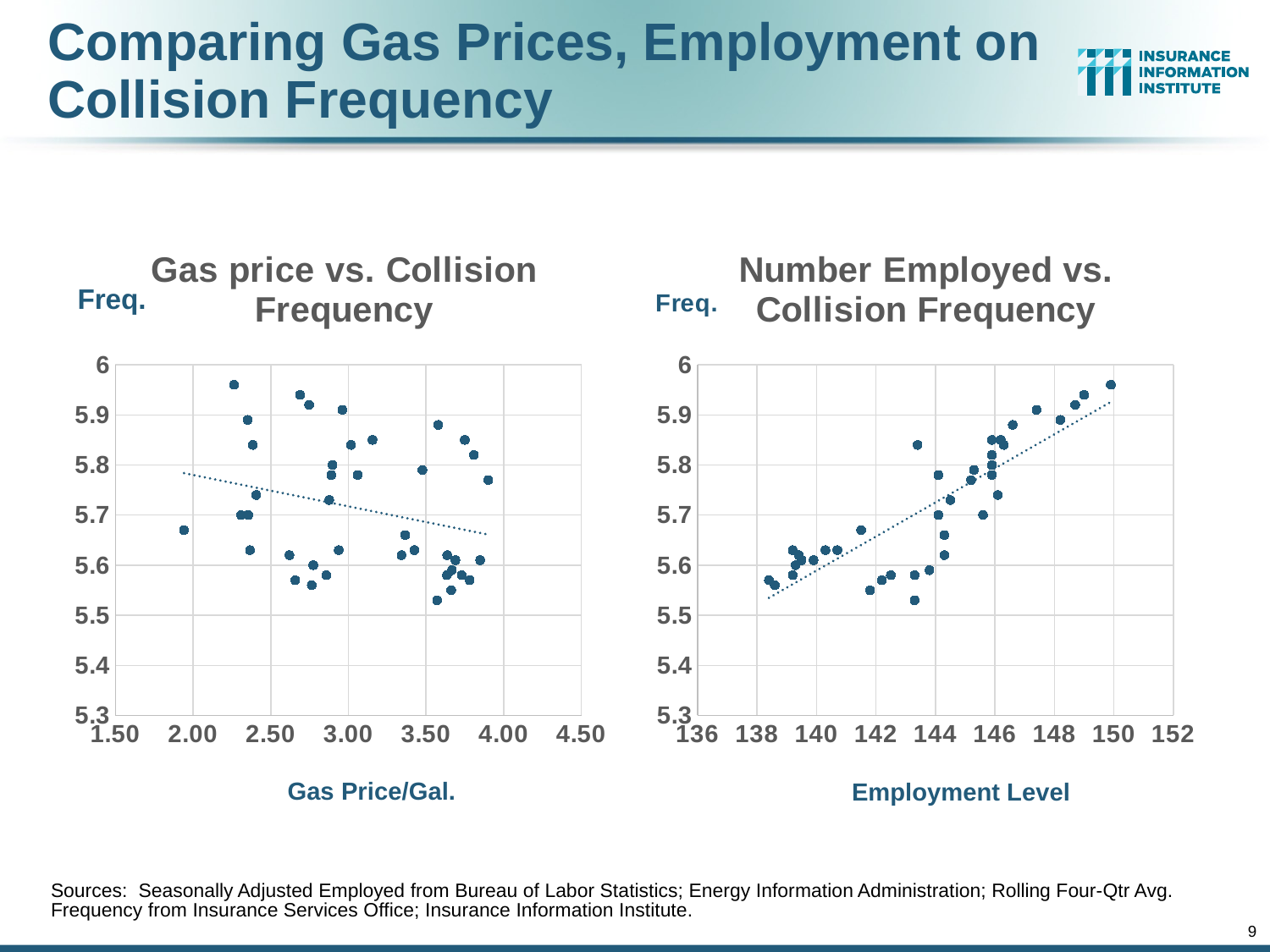
What kind of chart is the right chart titled "Number Employed vs. Collision Frequency"? Scatter chart In the right chart "Number Employed vs. Collision Frequency", is the frequency of the lowest point greater or less than 5.6? less In the left chart "Gas price vs. Collision Frequency", does the dotted trend line rise or fall as gas price increases? Fall In the right chart "Number Employed vs. Collision Frequency", does the dotted trend line rise or fall as employment level increases? Rise In the right chart "Number Employed vs. Collision Frequency", is the frequency of the point at employment level 150 greater or less than 5.9? greater In the left chart "Gas price vs. Collision Frequency", is the frequency of the lowest point greater or less than 5.6? less What is the x-axis label of the left chart "Gas price vs. Collision Frequency"? Gas Price/Gal. What kind of chart is the left chart titled "Gas price vs. Collision Frequency"? Scatter chart What is the x-axis label of the right chart "Number Employed vs. Collision Frequency"? Employment Level